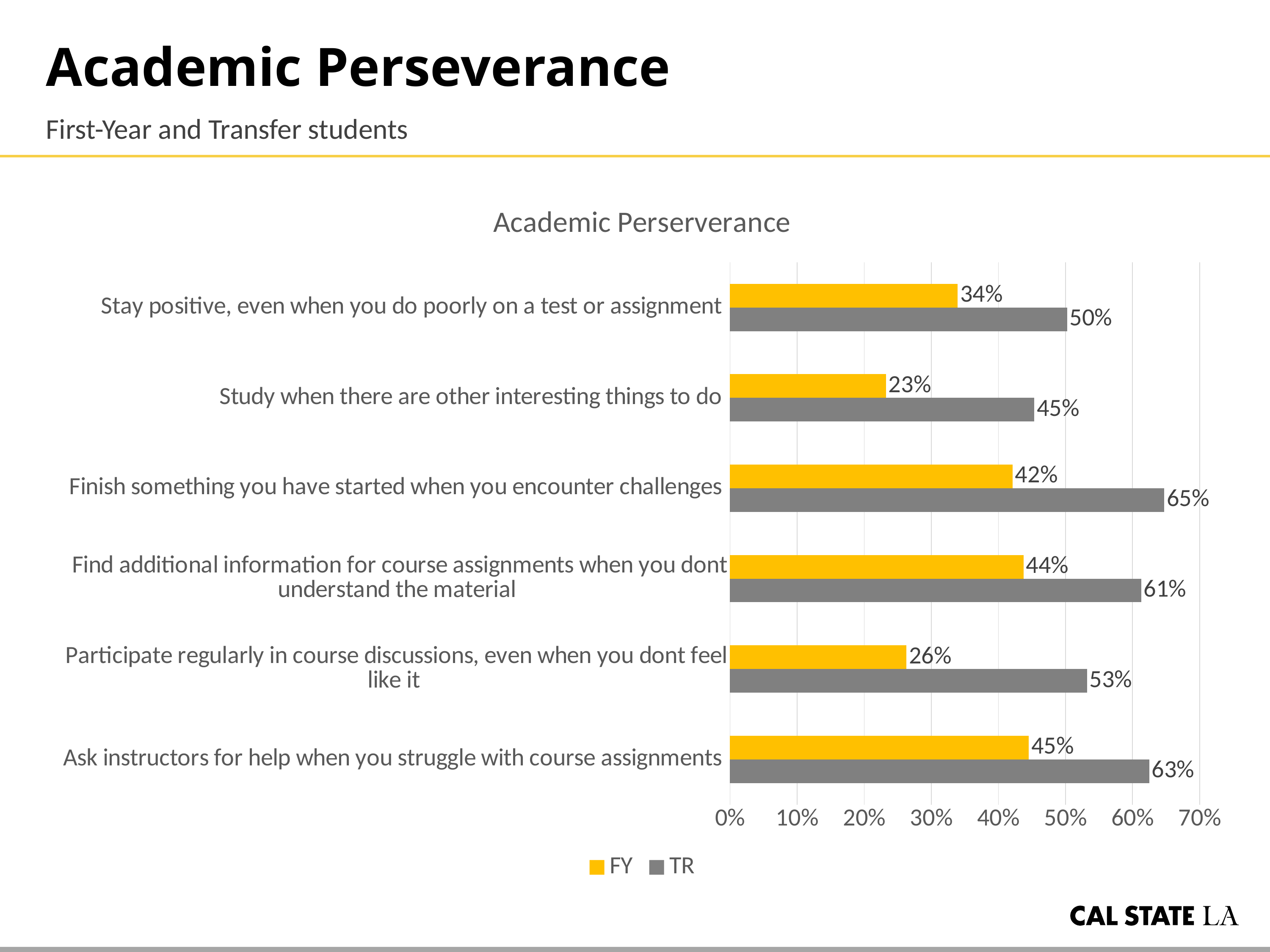
Is the TR value for "Find additional information for course assignments when you dont understand the material" greater or less than 50%? greater What kind of chart is shown on the slide? bar chart What is the difference between the TR and FY values for "Participate regularly in course discussions, even when you dont feel like it"? 27% Which is larger for "Ask instructors for help when you struggle with course assignments": the FY value or the TR value? TR How many categories are shown on the chart? 6 What is the TR value for "Finish something you have started when you encounter challenges"? 65% How many series does the legend list? 2 What is the FY value for "Study when there are other interesting things to do"? 23% Which category has the lowest FY value? Study when there are other interesting things to do Which category has the highest TR value? Finish something you have started when you encounter challenges What is the FY value for "Stay positive, even when you do poorly on a test or assignment"? 34% What is the title of the chart? Academic Perserverance